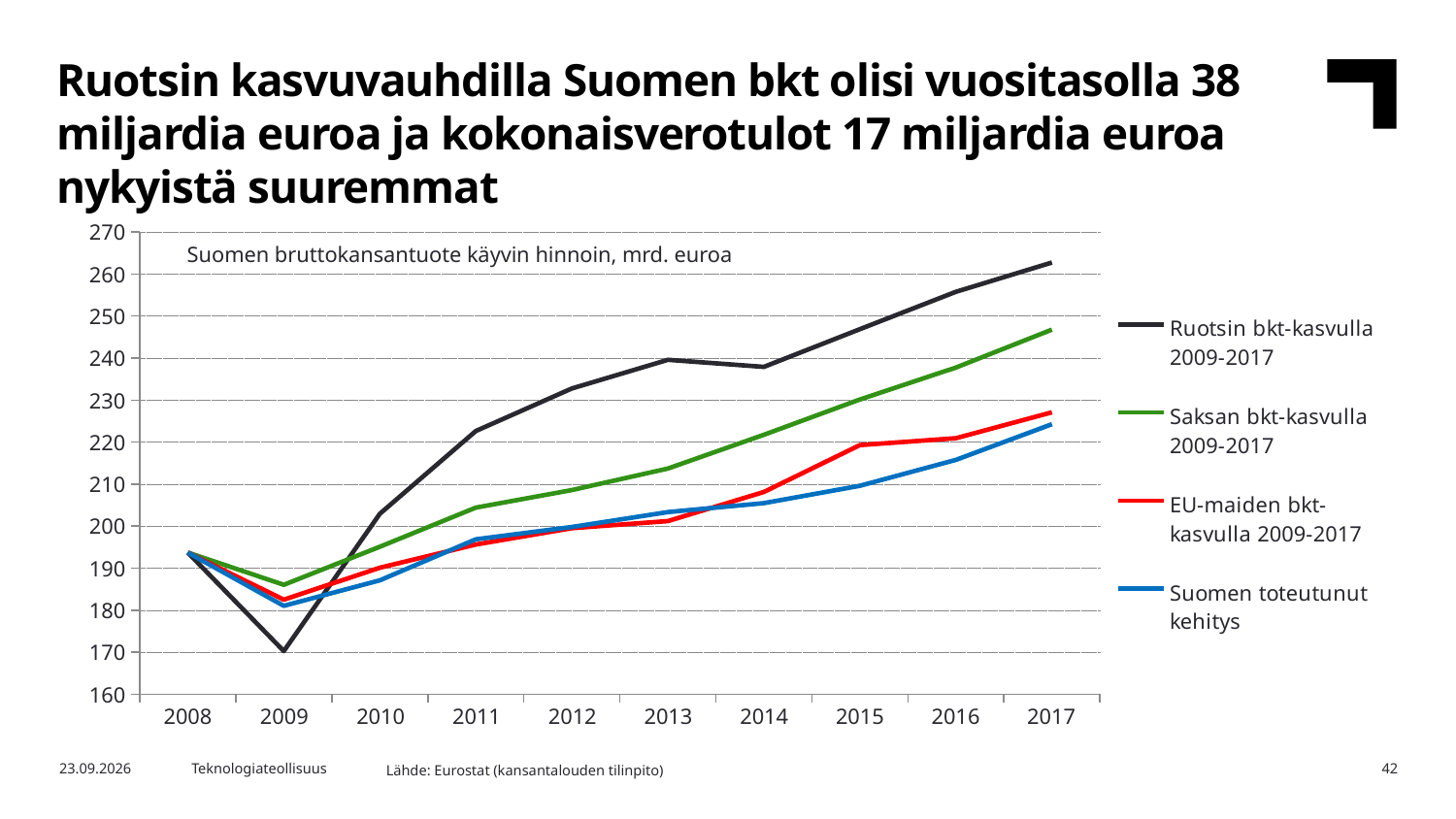
How many series does the legend list? 4 Which series has the lowest value in 2009? Ruotsin bkt-kasvulla 2009-2017 Is the value for Suomen toteutunut kehitys in 2017 greater or less than 230? less Does the Ruotsin bkt-kasvulla 2009-2017 series rise or fall from 2009 to 2017? rise What is the title shown inside the chart area? Suomen bruttokansantuote käyvin hinnoin, mrd. euroa What kind of chart is shown on the slide? line chart What colour is the line for Suomen toteutunut kehitys? blue Which series has the highest value in 2017? Ruotsin bkt-kasvulla 2009-2017 Is the value for Ruotsin bkt-kasvulla 2009-2017 in 2009 greater or less than 180? less How many years are shown on the x axis? 10 In 2017, which is larger: Saksan bkt-kasvulla 2009-2017 or EU-maiden bkt-kasvulla 2009-2017? Saksan bkt-kasvulla 2009-2017 Is the value for Ruotsin bkt-kasvulla 2009-2017 in 2017 greater or less than 250? greater